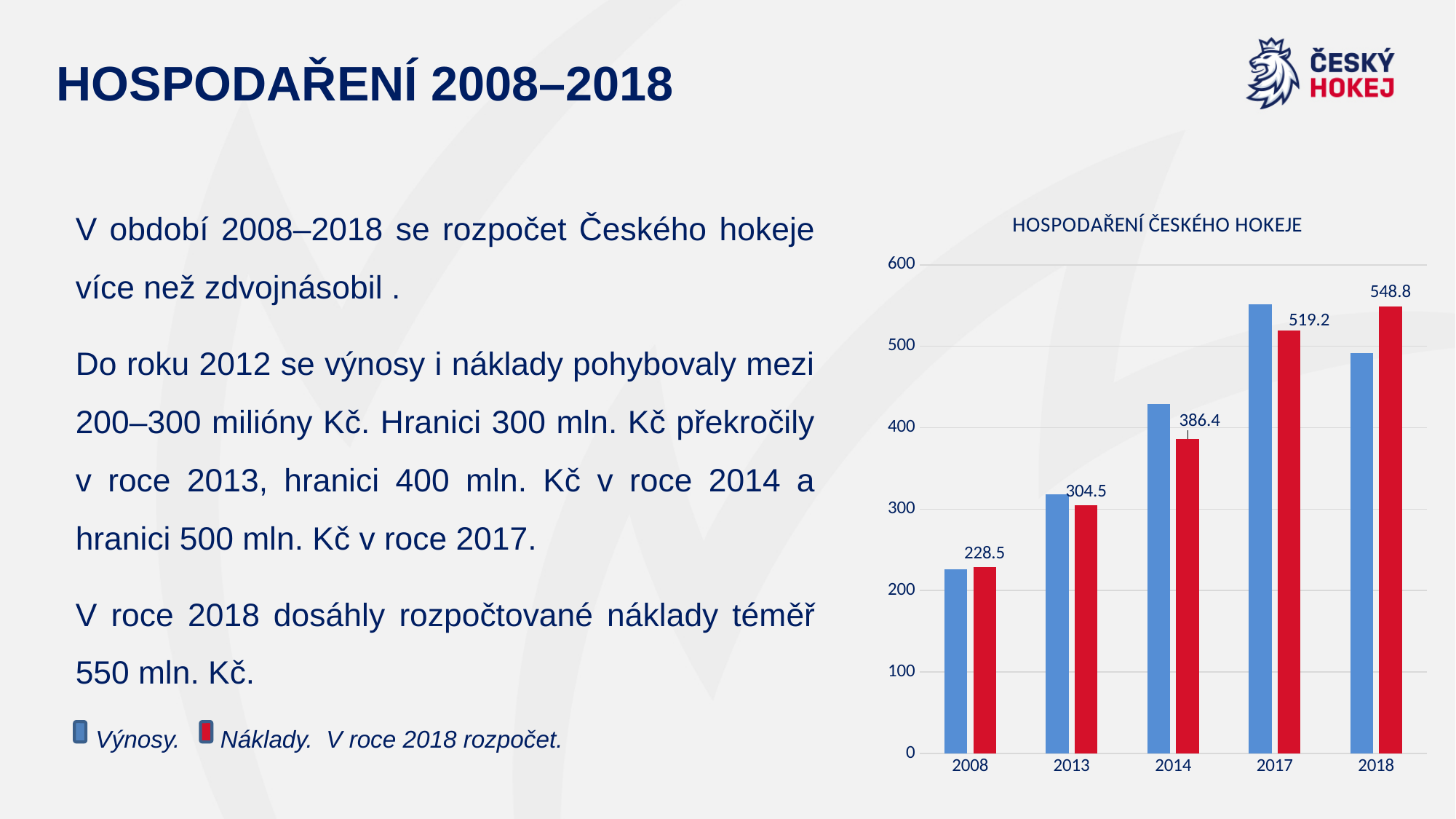
How many years are shown on the x axis of the chart? 5 In which year is Náklady the highest? 2018 What is the value of Náklady for 2014? 386.4 Is the value of Výnosy for 2017 greater or less than 500? greater What is the value of Náklady for 2008? 228.5 What is the value of Náklady for 2018? 548.8 In which year is Náklady the lowest? 2008 What is the title of the chart? HOSPODAŘENÍ ČESKÉHO HOKEJE What is the difference between Náklady in 2018 and Náklady in 2008? 320.3 What type of chart is shown on the slide? bar chart Do the Náklady values rise or fall from 2008 to 2018? rise How many data series does the chart show? 2